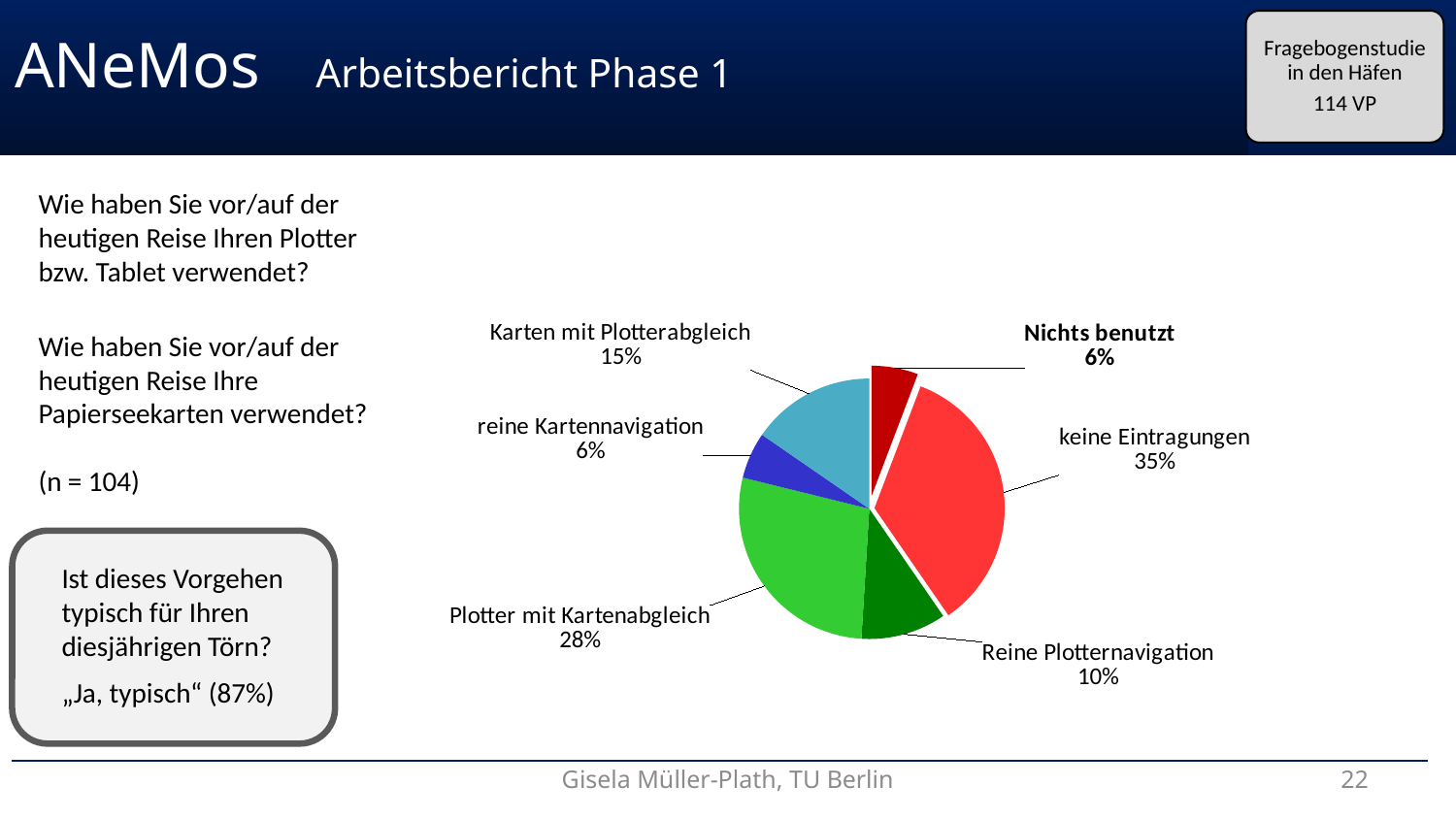
What is the combined share of "Plotter mit Kartenabgleich" and "Reine Plotternavigation"? 38% Which is larger: the slice for "Karten mit Plotterabgleich" or the slice for "Reine Plotternavigation"? Karten mit Plotterabgleich What type of chart is shown on the slide? Pie chart How many slices does the pie chart have? 6 What percentage is shown for "Reine Plotternavigation"? 10% What share does "Plotter mit Kartenabgleich" have in the pie chart? 28% What is the difference in percentage points between "keine Eintragungen" and "Plotter mit Kartenabgleich"? 7 Which two categories share the smallest slice of the pie chart at 6%? Nichts benutzt and reine Kartennavigation What percentage of the pie chart is labelled "keine Eintragungen"? 35% Which slice label in the pie chart is printed in bold? Nichts benutzt Which category has the largest slice of the pie chart? keine Eintragungen What percentage is shown for "Karten mit Plotterabgleich"? 15%